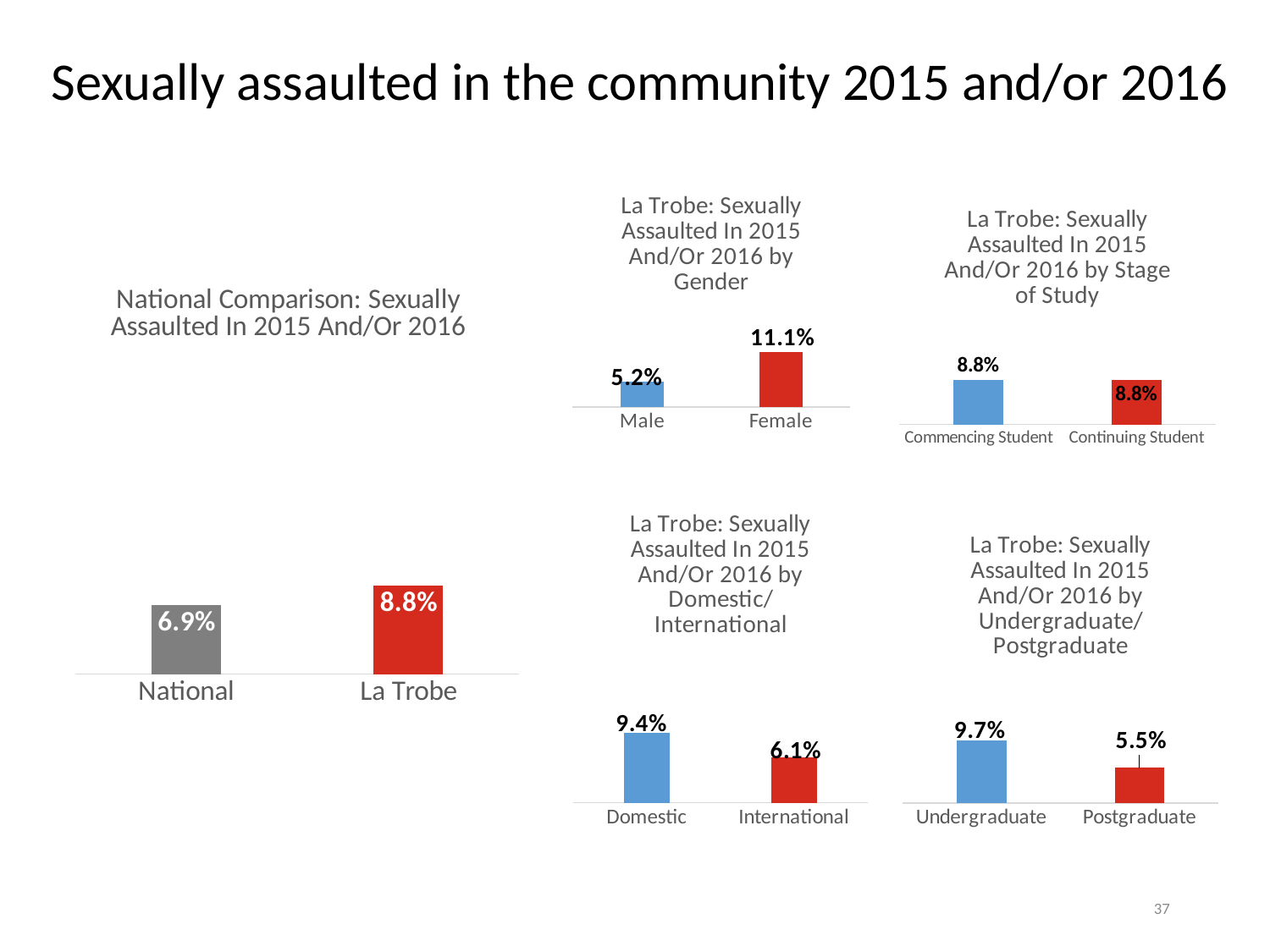
In the La Trobe by Gender chart, what is the value for Female? 11.1% In the La Trobe by Gender chart, what is the difference between the Female and Male values? 5.9% In the La Trobe by Undergraduate/Postgraduate chart, what is the difference between the Undergraduate and Postgraduate values? 4.2% In the La Trobe by Stage of Study chart, what is the value for Continuing Student? 8.8% In the La Trobe by Undergraduate/Postgraduate chart, which category has the lowest value? Postgraduate In the National Comparison chart, what is the difference between the La Trobe and National values? 1.9% In the National Comparison chart, what is the value for National? 6.9% What kind of chart is the National Comparison chart? Bar chart In the La Trobe by Domestic/International chart, what is the value for International? 6.1% In the National Comparison chart, what is the value for La Trobe? 8.8% In the La Trobe by Domestic/International chart, which is larger, Domestic or International? Domestic In the La Trobe by Gender chart, which category has the highest value? Female